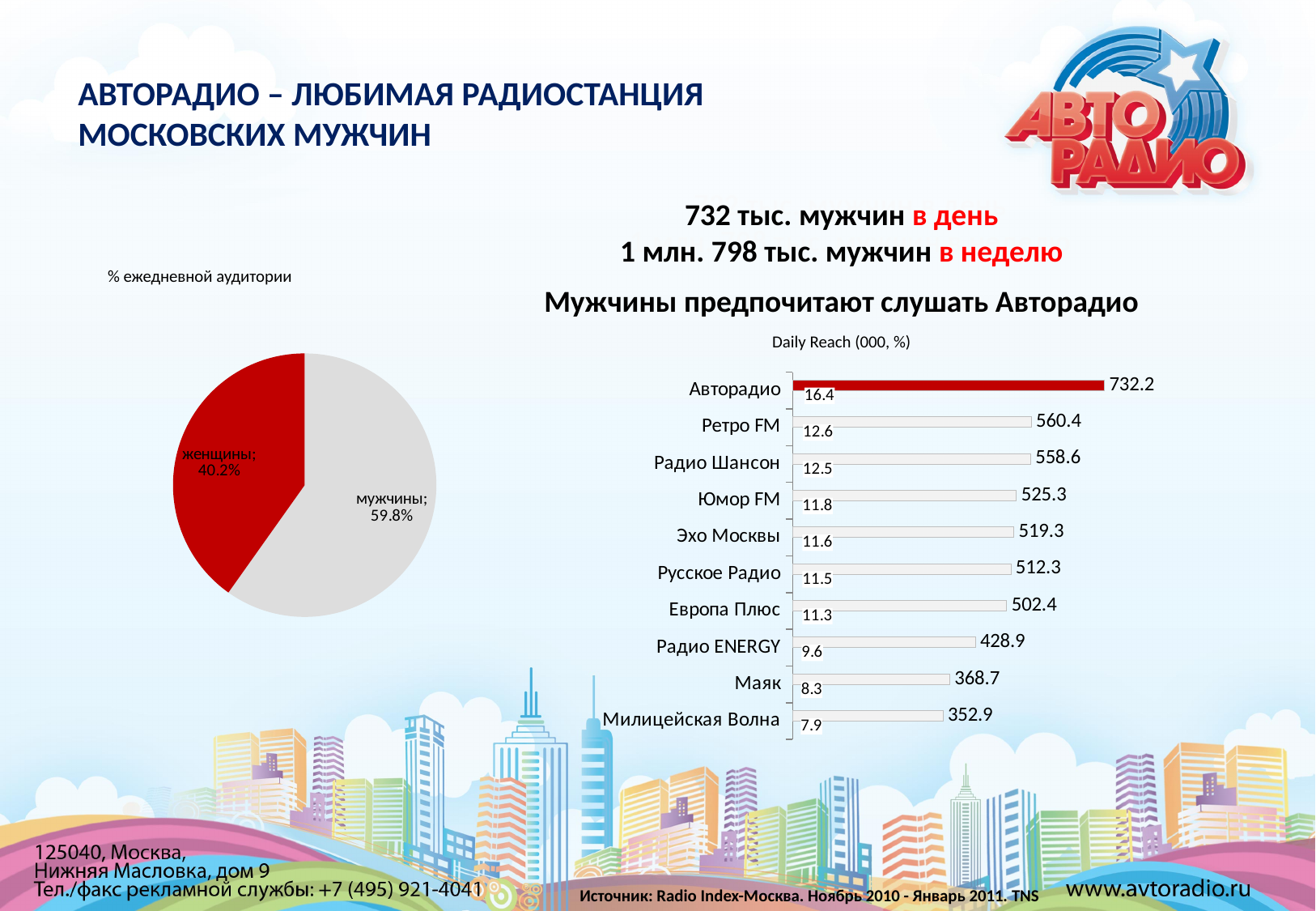
In the bar chart 'Daily Reach (000, %)', which station has the highest daily reach? Авторадио In the bar chart 'Daily Reach (000, %)', what is the daily reach in thousands for Авторадио? 732.2 In the pie chart '% ежедневной аудитории', which slice is larger, мужчины or женщины? мужчины In the bar chart 'Daily Reach (000, %)', which bar is coloured red? Авторадио In the pie chart '% ежедневной аудитории', how many slices are there? 2 In the bar chart 'Daily Reach (000, %)', how many radio stations are listed? 10 In the bar chart 'Daily Reach (000, %)', which station has the lowest daily reach? Милицейская Волна In the bar chart 'Daily Reach (000, %)', what is the percentage value shown for Ретро FM? 12.6 In the pie chart '% ежедневной аудитории', what share is labelled for мужчины? 59.8% In the pie chart '% ежедневной аудитории', what share is labelled for женщины? 40.2% In the bar chart 'Daily Reach (000, %)', what is the difference in thousands between Авторадио (732.2) and Ретро FM (560.4)? 171.8 What type of chart is the 'Daily Reach (000, %)' chart? bar chart